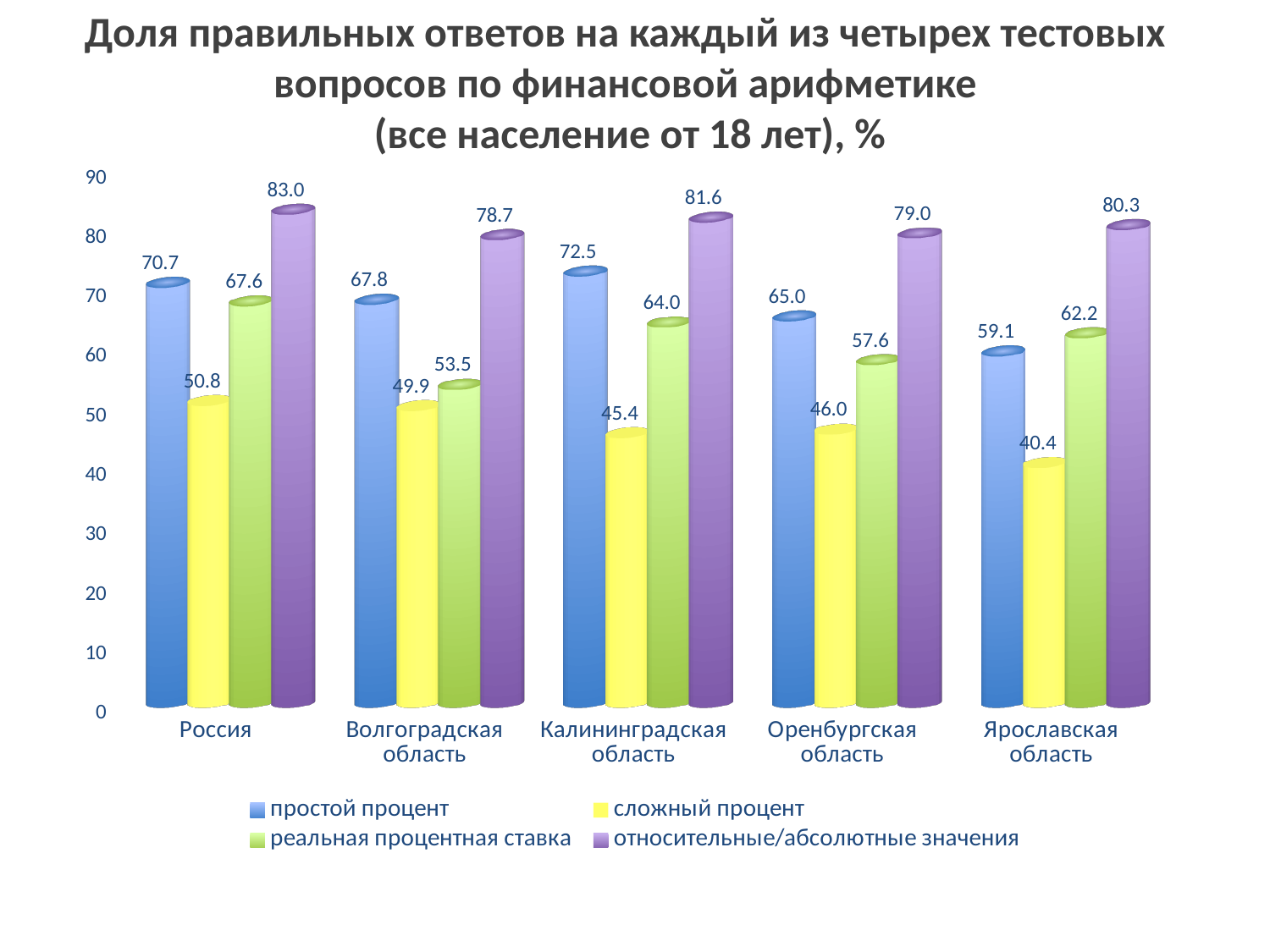
What kind of chart is shown on the slide? bar chart Is the value for "простой процент" in Ярославская область greater or less than 50? greater What is the value for "сложный процент" in Ярославская область? 40.4 How many regions (categories) are shown on the x axis? 5 Which colour represents "сложный процент" in the legend? yellow Which region has the lowest value for "сложный процент"? Ярославская область Which region has the highest value for "относительные/абсолютные значения"? Россия What is the difference between "простой процент" and "сложный процент" in Оренбургская область? 19.0 What is the value for "простой процент" in Россия? 70.7 What is the value for "относительные/абсолютные значения" in Калининградская область? 81.6 How many series does the legend list? 4 Which is larger: "реальная процентная ставка" in Волгоградская область or in Калининградская область? Калининградская область